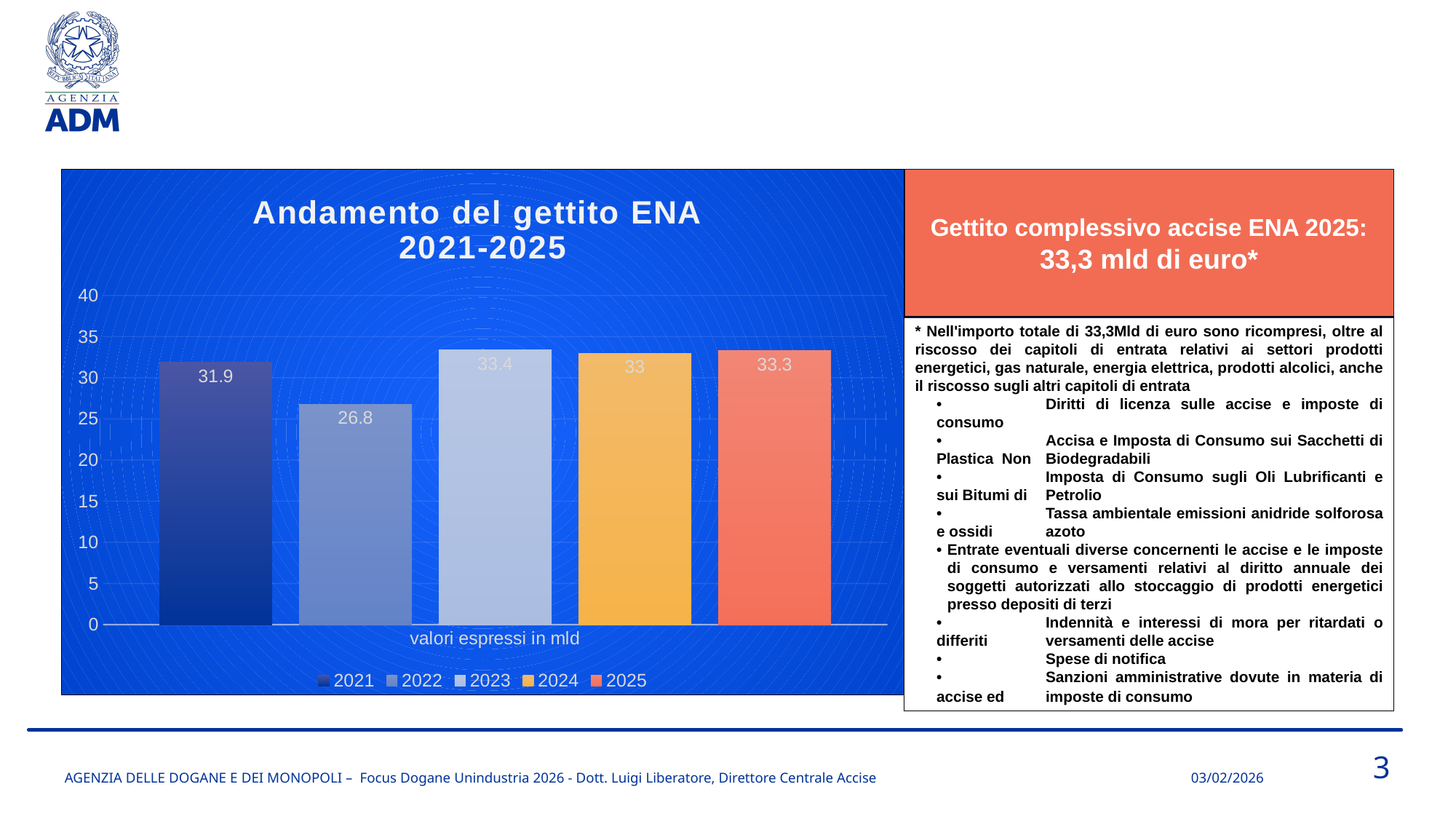
What kind of chart is shown on the slide? bar chart Which year has the lowest value in the chart? 2022 What is the value for 2021 in the chart 'Andamento del gettito ENA 2021-2025'? 31.9 What is the difference between the values for 2021 and 2022? 5.1 Which year has the highest value in the chart? 2023 What is the value for 2025 in the chart? 33.3 Which is larger, the value for 2021 or the value for 2024? 2024 What is the difference between the values for 2023 and 2022? 6.6 What is the value for 2022 in the chart? 26.8 How many entries does the chart legend list? 5 How many bars are shown in the chart? 5 Is the value for 2022 greater or less than 30? less